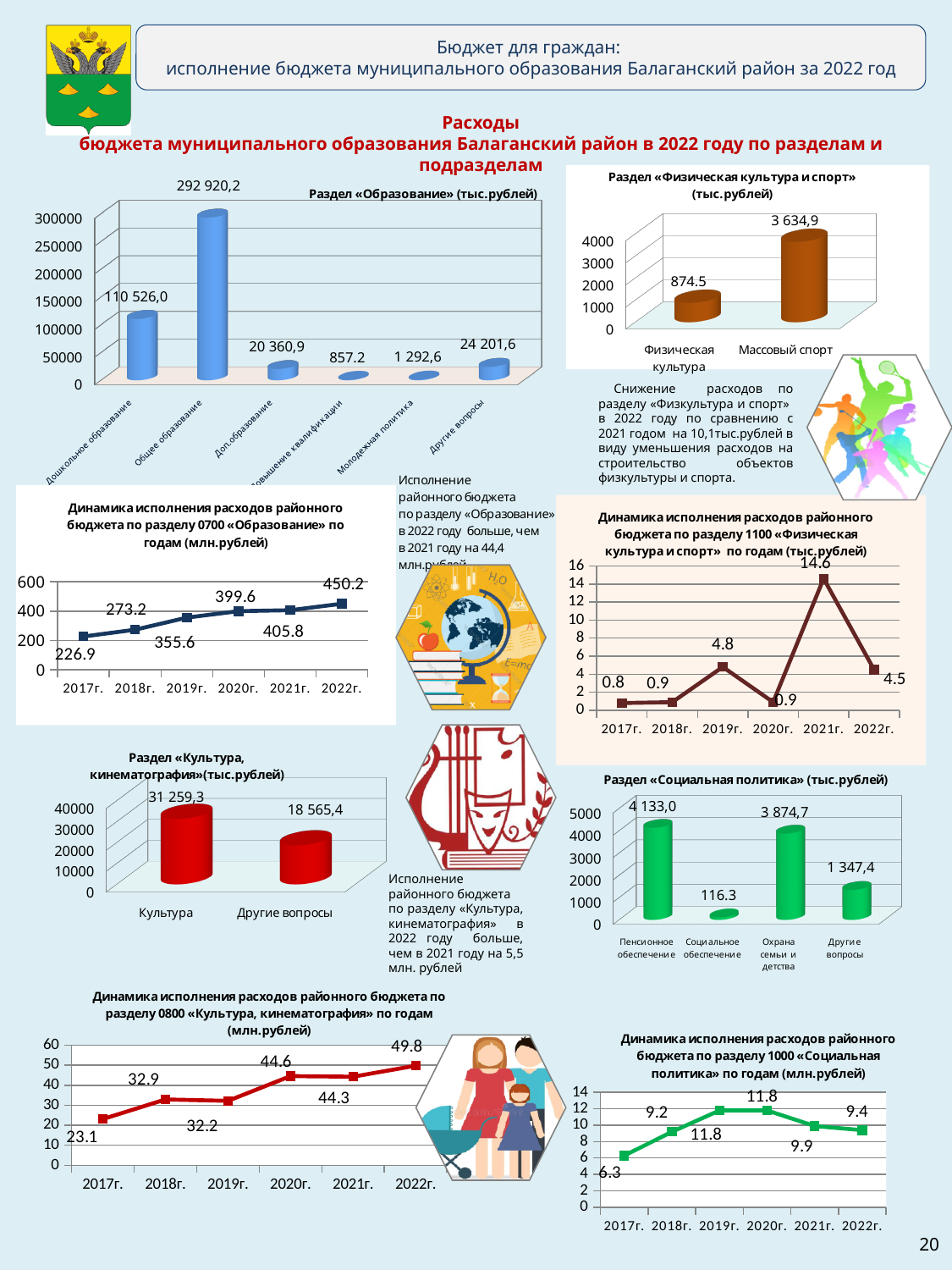
In the chart «Раздел «Социальная политика» (тыс.рублей)», which is larger: Пенсионное обеспечение or Охрана семьи и детства? Пенсионное обеспечение In the chart «Динамика исполнения расходов районного бюджета по разделу 1000 «Социальная политика» по годам (млн.рублей)», what is the value for 2017г.? 6.3 In the chart «Раздел «Культура, кинематография»(тыс.рублей)», what is the difference between Культура and Другие вопросы? 12 693,9 In the chart «Раздел «Физическая культура и спорт» (тыс.рублей)», what is the value for Массовый спорт? 3 634,9 In the chart «Раздел «Образование» (тыс.рублей)», how many categories are shown? 6 In the chart «Динамика исполнения расходов районного бюджета по разделу 0700 «Образование» по годам (млн.рублей)», do the values rise or fall from 2017г. to 2022г.? rise What kind of chart is «Раздел «Культура, кинематография»(тыс.рублей)»? bar chart In the chart «Динамика исполнения расходов районного бюджета по разделу 0800 «Культура, кинематография» по годам (млн.рублей)», what is the value for 2019г.? 32.2 In the chart «Динамика исполнения расходов районного бюджета по разделу 1100 «Физическая культура и спорт» по годам (тыс.рублей)», which year has the highest value? 2021г. In the chart «Раздел «Образование» (тыс.рублей)», which category has the lowest value? Повышение квалификации In the chart «Раздел «Образование» (тыс.рублей)», what is the value for Общее образование? 292 920,2 In the chart «Динамика исполнения расходов районного бюджета по разделу 0700 «Образование» по годам (млн.рублей)», what is the value for 2022г.? 450.2